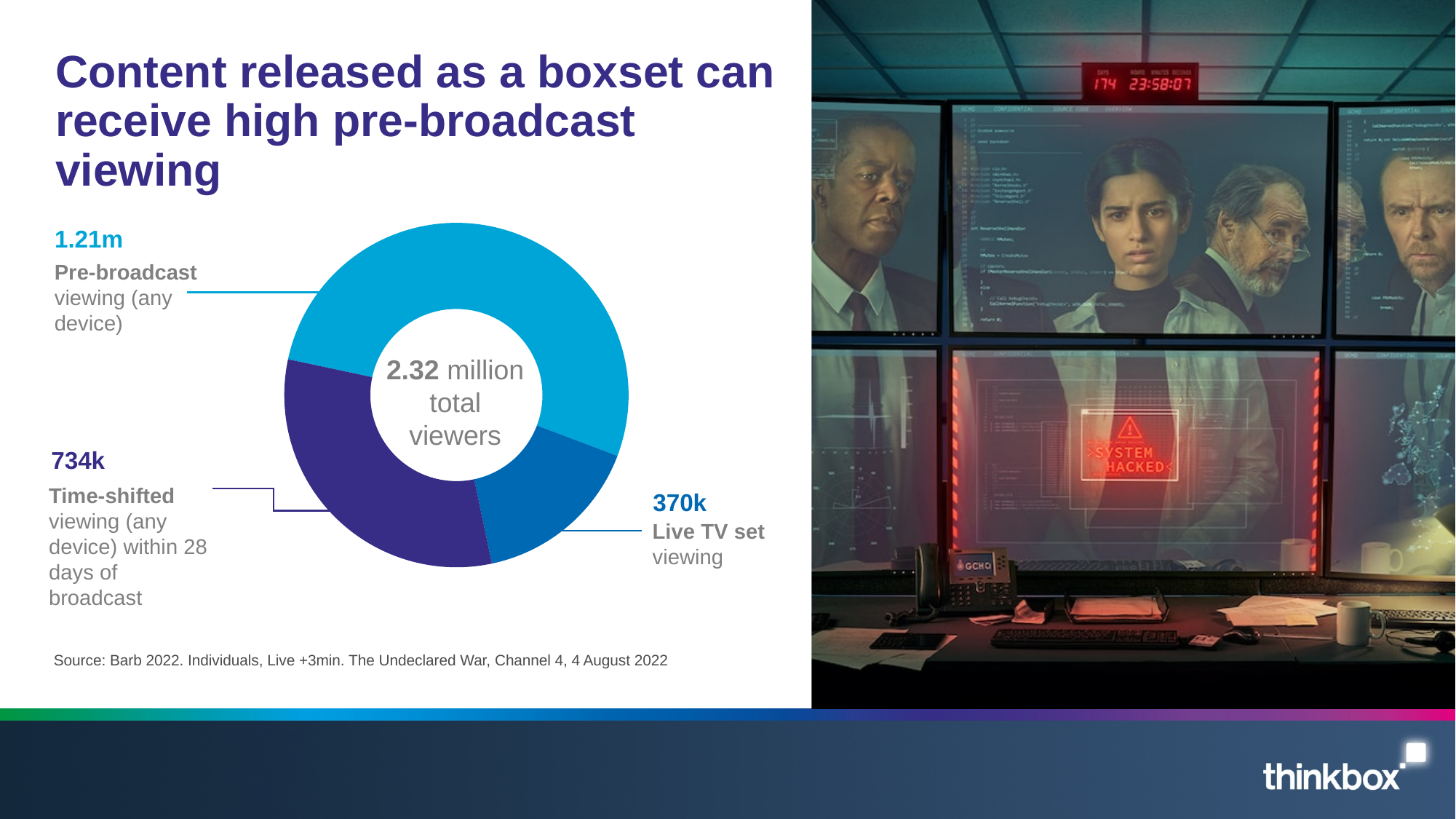
Which segment of the donut chart is the largest? Pre-broadcast viewing (any device) What colour is the Pre-broadcast viewing segment of the donut chart? Light blue What kind of chart is shown on the slide? Donut (pie) chart How many segments does the donut chart have? 3 Which segment of the donut chart is the smallest? Live TV set viewing What is the total number of viewers shown in the centre of the donut chart? 2.32 million What is the value for Time-shifted viewing (any device) within 28 days of broadcast? 734k What is the difference between Time-shifted viewing (734k) and Live TV set viewing (370k)? 364k What is the value for Live TV set viewing? 370k Which is larger, Time-shifted viewing or Live TV set viewing? Time-shifted viewing What is the value for Pre-broadcast viewing (any device)? 1.21m What is the source cited for the chart? Barb 2022. Individuals, Live +3min. The Undeclared War, Channel 4, 4 August 2022